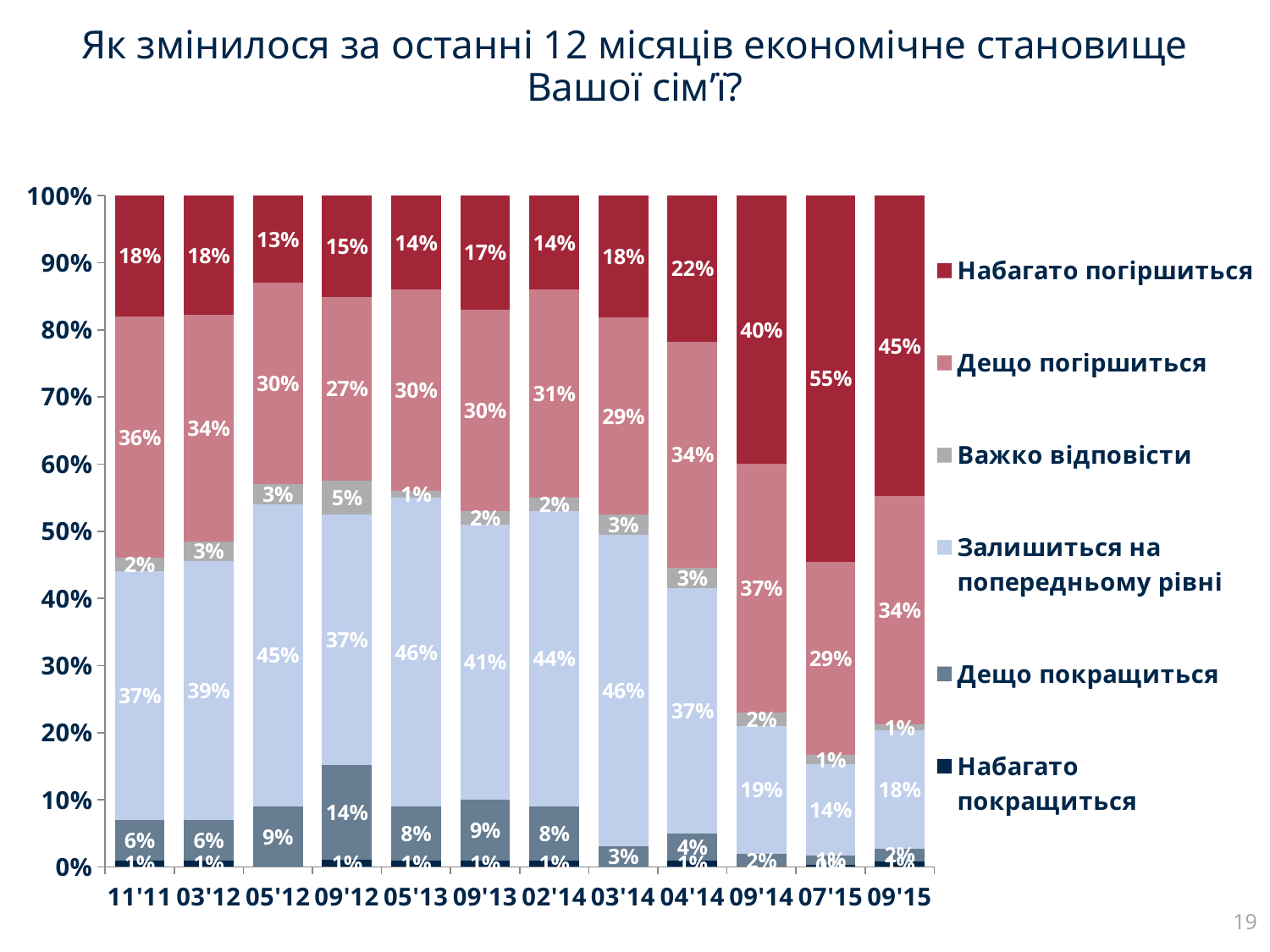
What is the value of "Залишиться на попередньому рівні" for 05'13? 46% What is the value of "Важко відповісти" for 09'12? 5% What kind of chart is shown on the slide? Stacked bar chart By how many percentage points does "Набагато погіршиться" differ between 09'14 and 04'14? 18 percentage points What is the value of "Набагато погіршиться" for 07'15? 55% Which period has the larger "Дещо погіршиться" value, 11'11 or 09'15? 11'11 How many time periods (categories) are shown on the x axis? 12 What is the value of "Дещо покращиться" for 09'12? 14% Does the "Набагато погіршиться" share rise or fall from 03'14 to 07'15? Rise In which period is the "Залишиться на попередньому рівні" share the lowest? 07'15 In which period is the "Набагато погіршиться" share the highest? 07'15 How many series does the legend list? 6